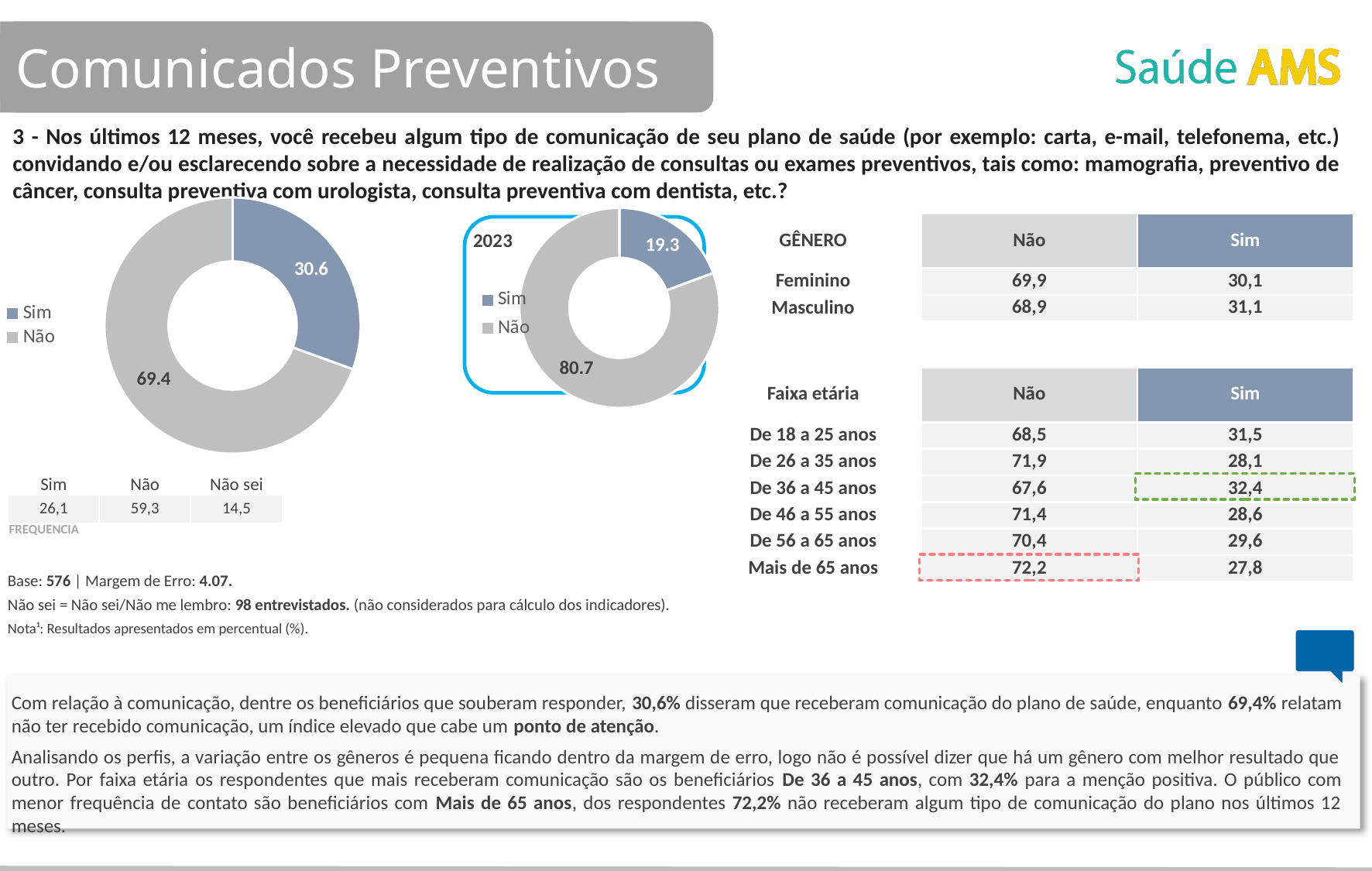
In the large donut chart on the left, what is the difference between the "Não" and "Sim" values? 38.8 Which is larger: the "Sim" value in the large donut chart on the left or the "Sim" value in the 2023 donut chart? The large donut chart on the left (30.6) In the large donut chart on the left, which category has the largest slice? Não In the large donut chart on the left, which colour represents "Sim"? Blue In the donut chart labelled 2023, which category has the smallest slice? Sim In the donut chart labelled 2023, what is the value for "Não"? 80.7 In the donut chart labelled 2023, what is the difference between the "Não" and "Sim" values? 61.4 In the large donut chart on the left, what is the value for "Sim"? 30.6 In the donut chart labelled 2023, what is the value for "Sim"? 19.3 How many categories does the large donut chart on the left show? 2 In the large donut chart on the left, what is the value for "Não"? 69.4 What type of chart is used to show the Sim/Não split on the left of the slide? Donut (pie) chart